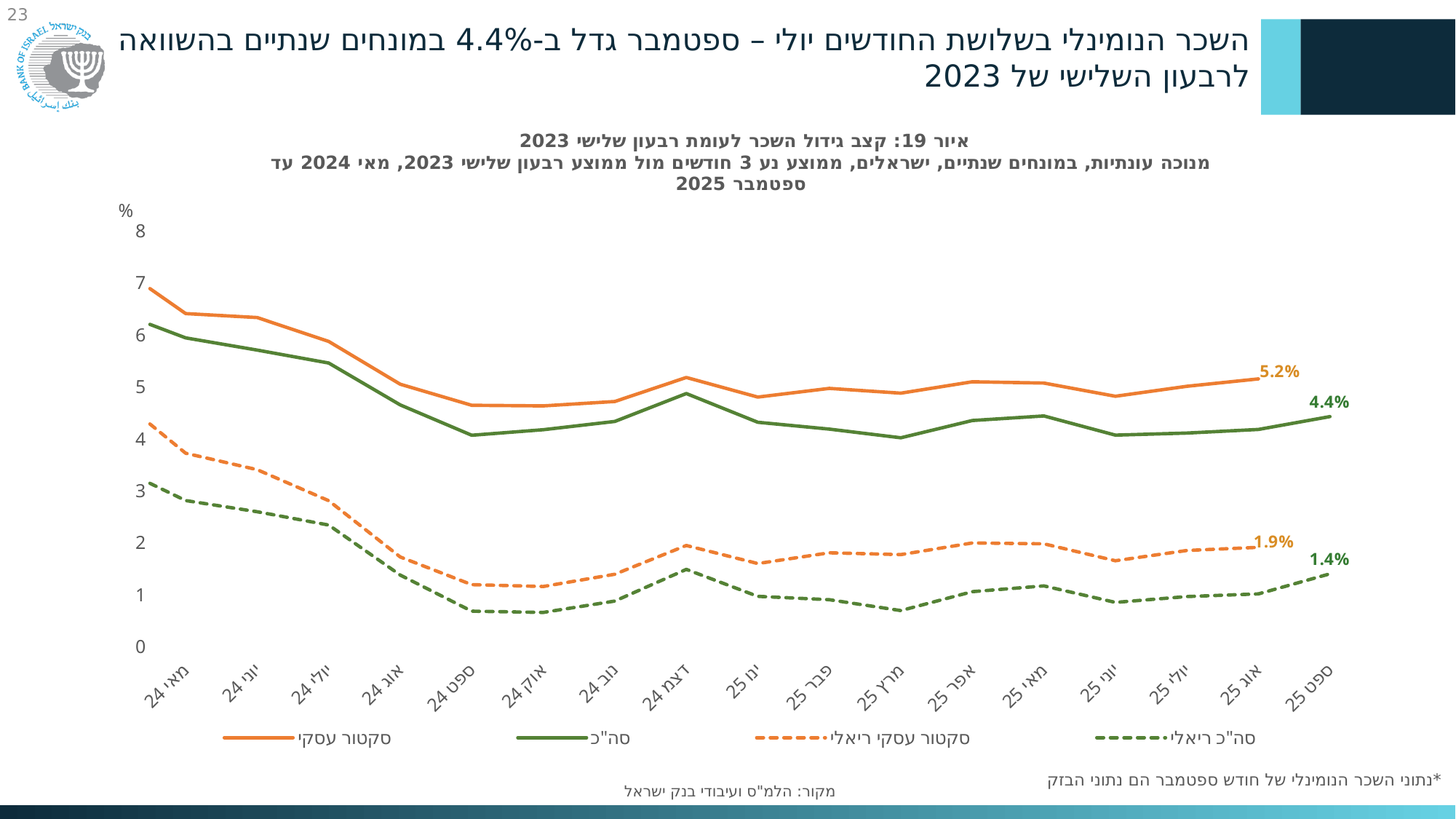
What is the value of the סה"כ ריאלי series at ספט 25? 1.4% How many months are plotted along the x axis? 17 What type of chart is shown on the slide? line chart What is the value of the סה"כ series at ספט 25? 4.4% How many series does the legend list? 4 At ספט 25, which series has the highest value? סה"כ Does the סקטור עסקי series rise or fall between מאי 24 and ספט 24? fall Is the value of the סקטור עסקי series at מאי 24 greater or less than 6? greater Is the value of the סה"כ ריאלי series at ספט 24 greater or less than 1? less